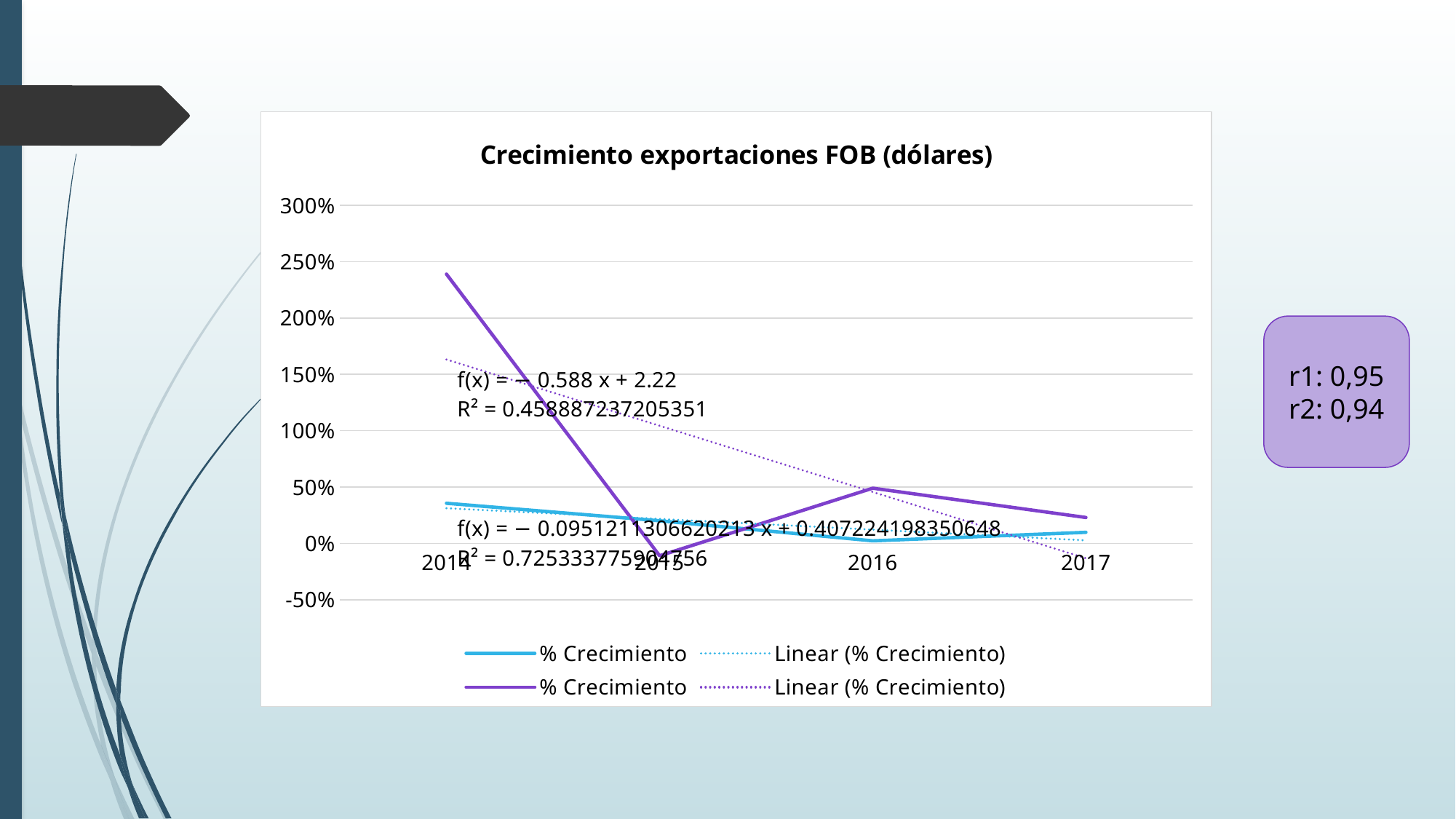
How many entries does the chart's legend list? 4 Does the purple % Crecimiento line rise or fall between 2014 and 2015? fall In which year does the blue % Crecimiento line reach its highest value? 2014 Is the value of the blue % Crecimiento line in 2014 greater or less than 50%? less Is the value of the purple % Crecimiento line in 2014 greater or less than 200%? greater In which year does the purple % Crecimiento line reach its lowest value? 2015 Is the value of the purple % Crecimiento line in 2017 greater or less than 50%? less What kind of chart is shown on the slide? line chart In 2016, which line has the higher value, the purple % Crecimiento line or the blue % Crecimiento line? the purple line In which year does the purple % Crecimiento line reach its highest value? 2014 What is the title of the chart? Crecimiento exportaciones FOB (dólares) How many years are shown on the x axis of the chart? 4